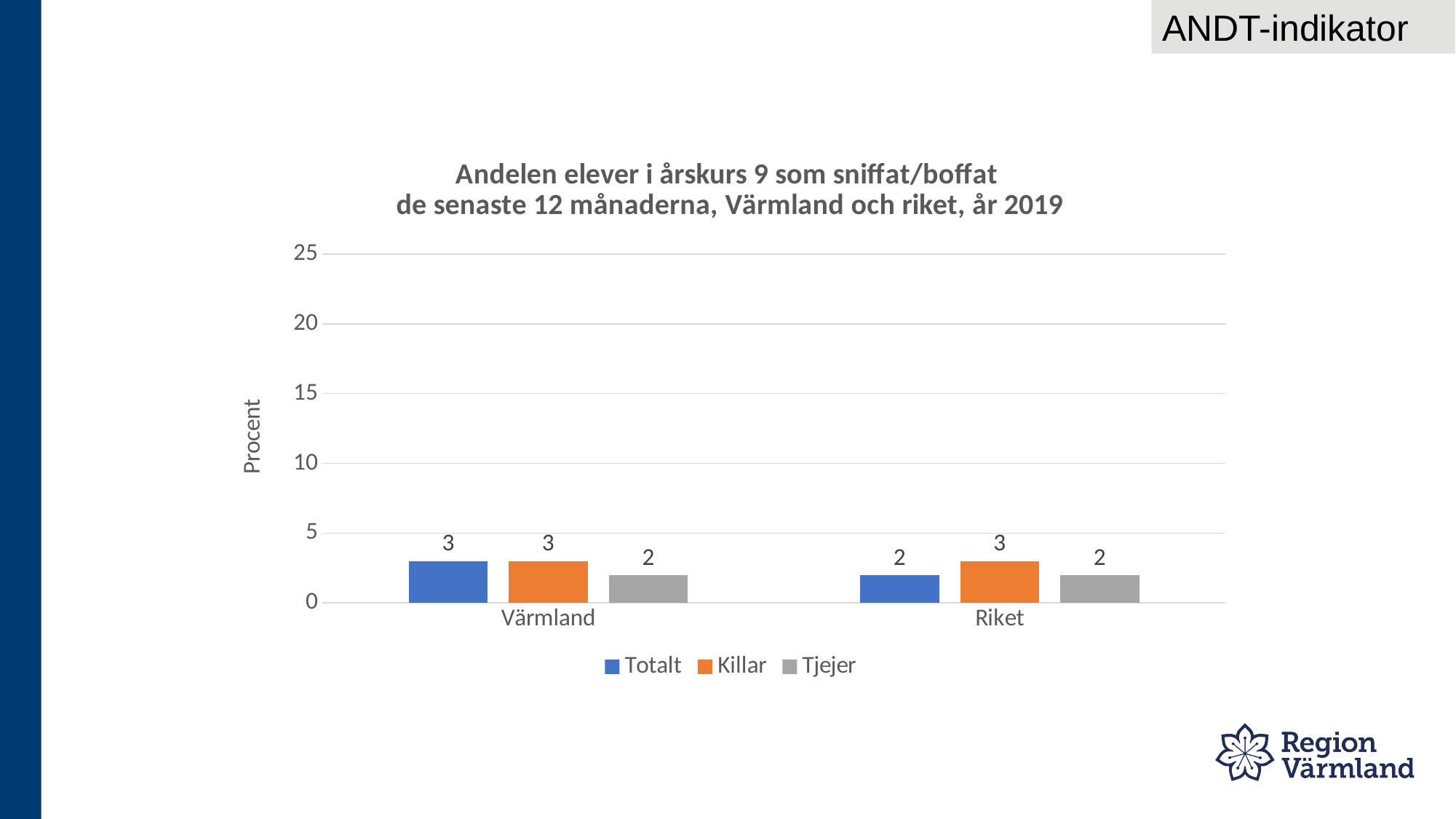
What is the value for Tjejer in Riket? 2 Which series is shown in orange? Killar How many series does the legend list? 3 Is the value for Killar in Värmland greater or less than 5? less What is the value for Killar in Riket? 3 How many categories are shown on the x axis? 2 What is the value for Totalt in Riket? 2 What kind of chart is shown on the slide? bar chart What is the difference between the Totalt values for Värmland and Riket? 1 What is the label of the y axis? Procent What is the value for Totalt in Värmland? 3 Which is larger in Värmland, the value for Killar or the value for Tjejer? Killar